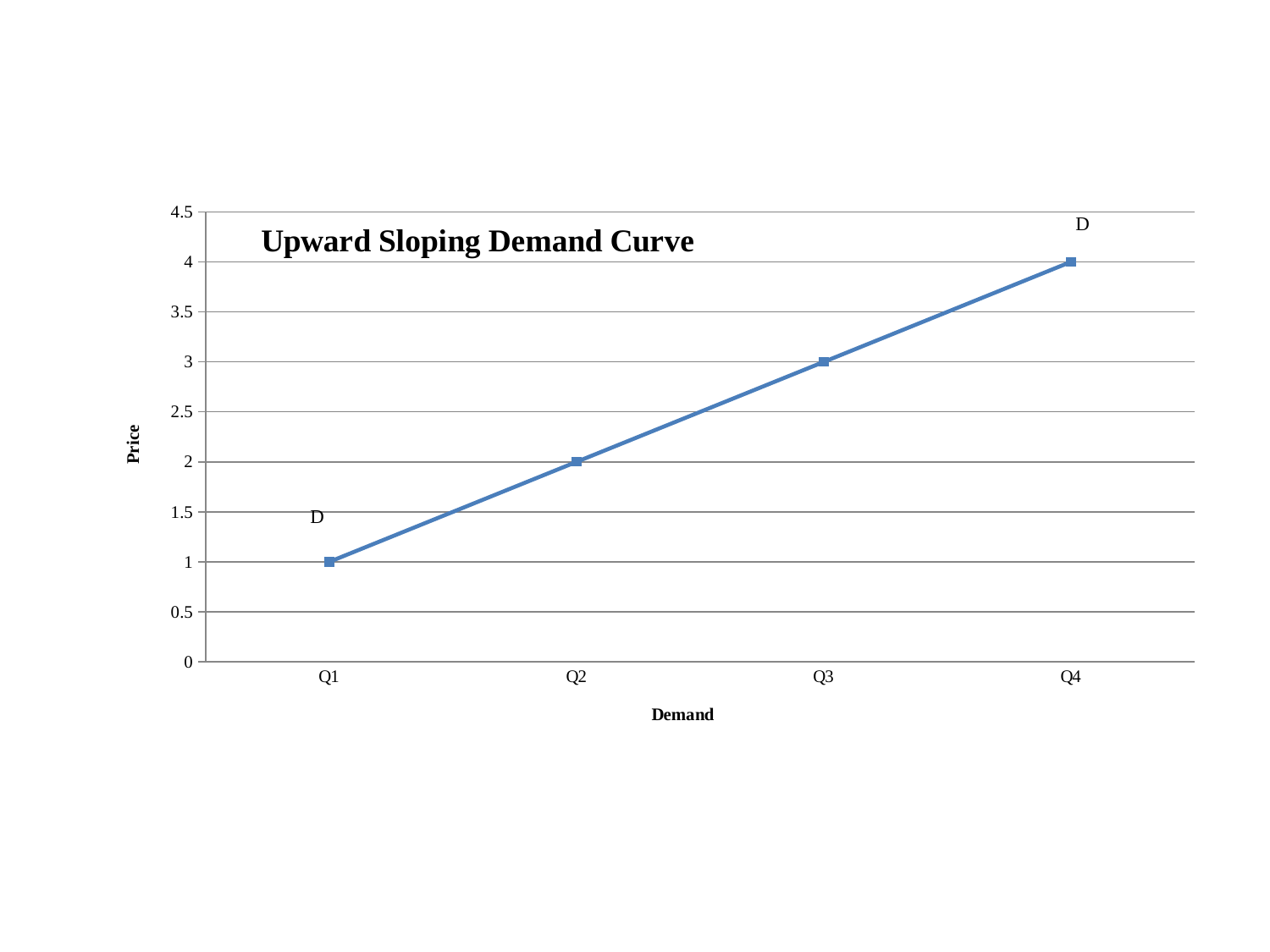
What kind of chart is shown on the slide? line chart What is the label of the x axis? Demand Which category has the highest Price? Q4 Which has a higher Price, Q2 or Q3? Q3 What is the Price value at Q4? 4 What is the Price value at Q1? 1 How many data points are plotted on the line? 4 Which category has the lowest Price? Q1 Do the values rise or fall from Q1 to Q4? rise What is the Price value at Q3? 3 What is the difference in Price between Q4 and Q2? 2 What is the title of the chart? Upward Sloping Demand Curve